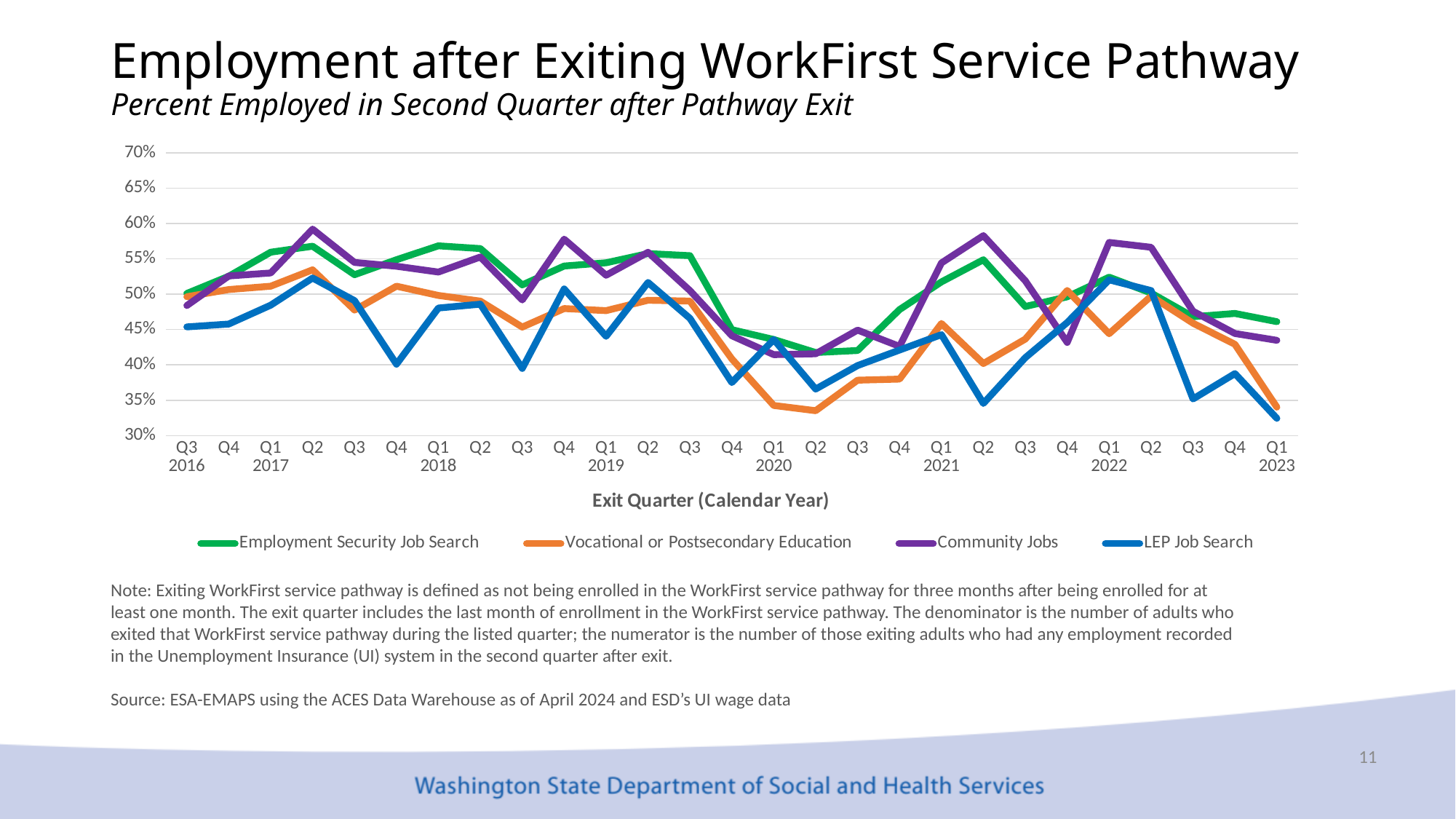
Is the value for Community Jobs in Q2 2017 greater or less than 55%? greater Is the value for LEP Job Search in Q1 2023 greater or less than 35%? less Which series has the lowest value in Q1 2023? LEP Job Search In Q2 2021, which is higher: Community Jobs or LEP Job Search? Community Jobs How many exit quarters are plotted along the x axis? 27 Which series has the highest value in Q2 2017? Community Jobs Is the value for Vocational or Postsecondary Education in Q2 2020 greater or less than 35%? less Does the LEP Job Search line rise or fall from Q2 2022 to Q1 2023? Fall What kind of chart is shown on the slide? Line chart What is the title of the x axis? Exit Quarter (Calendar Year) How many series does the legend list? 4